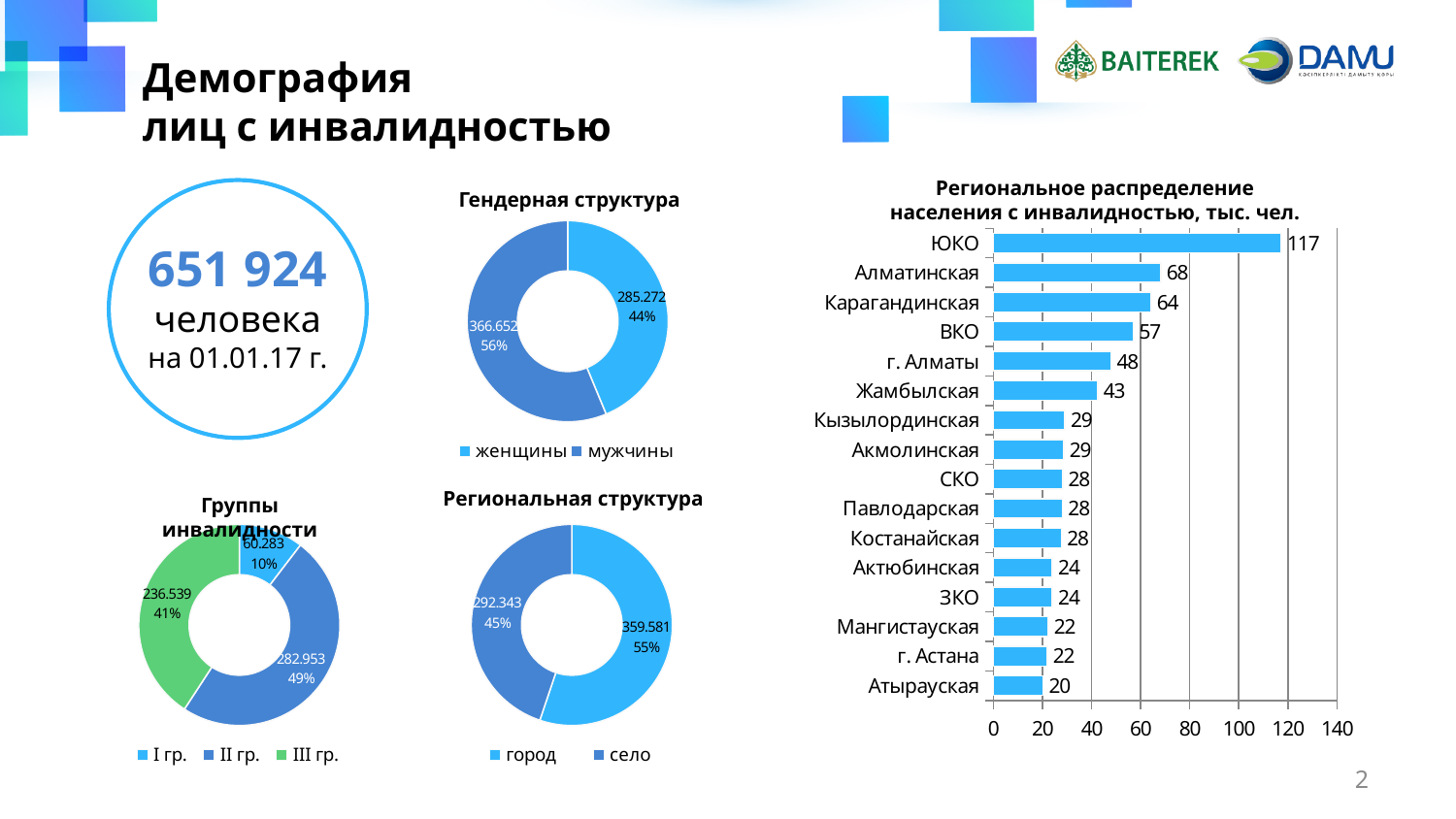
In the chart 'Группы инвалидности', what is the value for I гр.? 60.283 In the chart 'Региональное распределение населения с инвалидностью, тыс. чел.', which is larger: г. Алматы or Жамбылская? г. Алматы In the chart 'Группы инвалидности', what share is shown for II гр.? 49% In the chart 'Региональное распределение населения с инвалидностью, тыс. чел.', what is the difference between Алматинская and Карагандинская? 4 In the chart 'Региональное распределение населения с инвалидностью, тыс. чел.', which region has the highest value? ЮКО In the chart 'Гендерная структура', what share is shown for женщины? 44% In the chart 'Региональное распределение населения с инвалидностью, тыс. чел.', what is the value for ЮКО? 117 In the chart 'Региональная структура', what share is shown for село? 45% In the chart 'Гендерная структура', what is the value for мужчины? 366.652 In the chart 'Региональное распределение населения с инвалидностью, тыс. чел.', how many regions are shown? 16 What type of chart is 'Региональное распределение населения с инвалидностью, тыс. чел.'? bar chart In the chart 'Региональное распределение населения с инвалидностью, тыс. чел.', which region has the lowest value? Атырауская